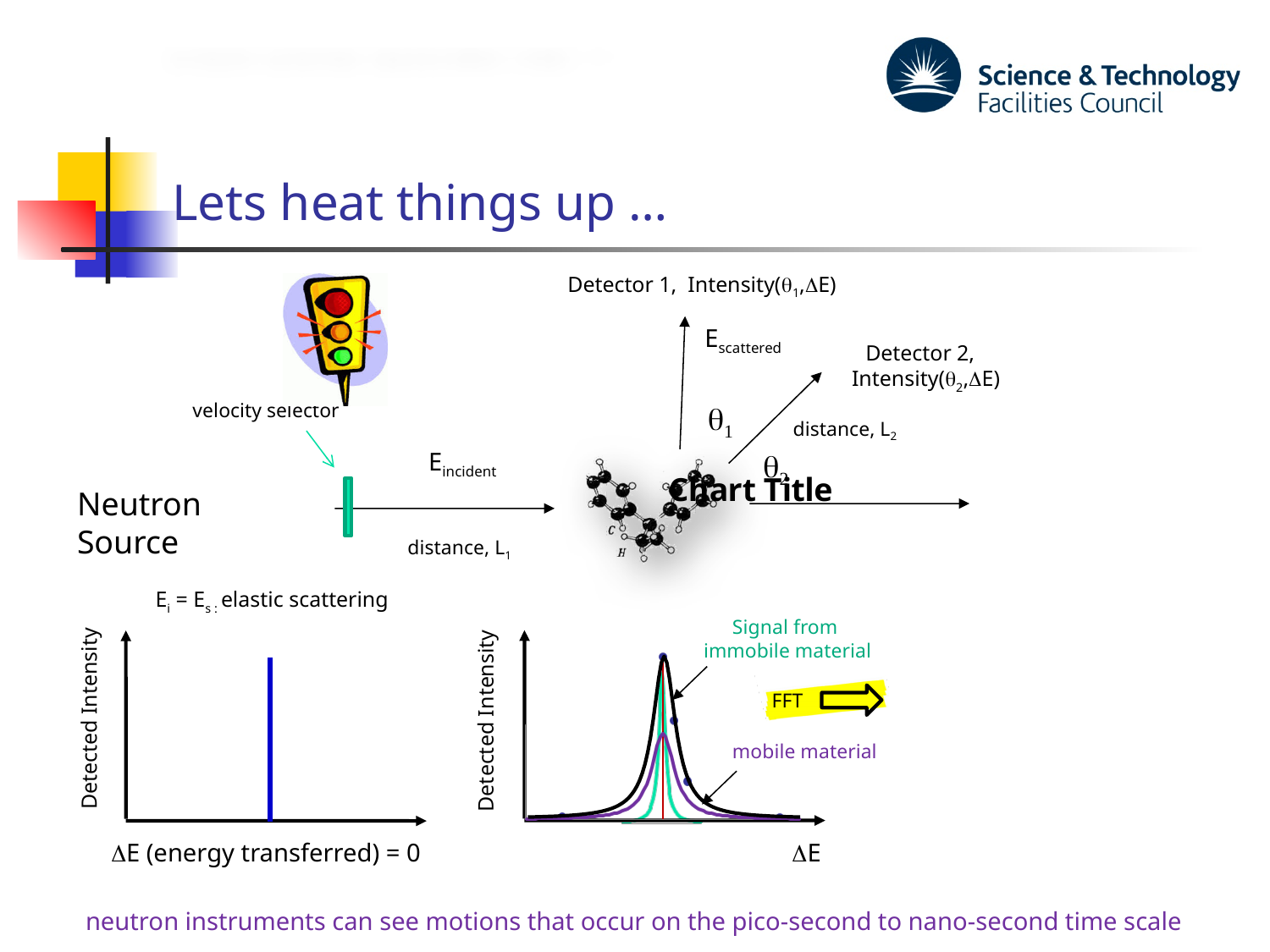
In the plot on the lower right, does the detected intensity rise or fall as ΔE approaches the central peak from the left? rise What kind of chart is the plot on the lower right of the slide? line chart How many curves are drawn in the plot on the lower right of the slide? 3 In the plot on the lower right, which signal has the higher peak, the immobile material or the mobile material? immobile material What is the x-axis label of the plot on the lower right of the slide? ΔE What is the y-axis label of the plot on the lower left of the slide? Detected Intensity In the plot on the lower right, does the detected intensity rise or fall as ΔE moves to the right of the central peak? fall How many peaks are shown in the plot on the lower left of the slide? 1